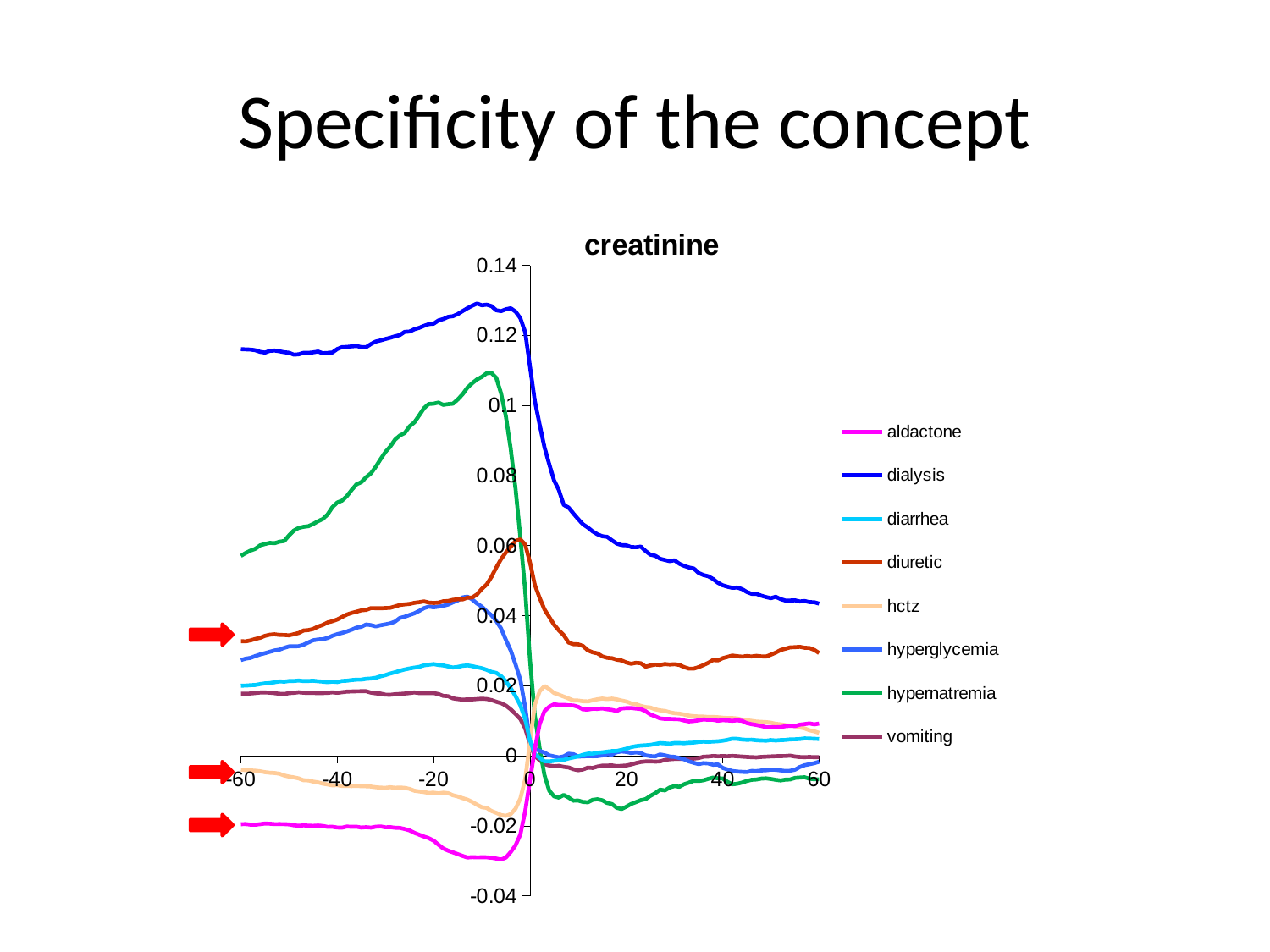
What is the title of the chart? creatinine Is the value of the diuretic line at x = 60 greater or less than 0.02? greater At x = -60, which is larger: the dialysis value or the hypernatremia value? dialysis Which series reaches the lowest value on the creatinine chart? aldactone Does the dialysis line rise or fall between x = 0 and x = 60? fall Is the value of the hypernatremia line at x = -60 greater or less than 0.04? greater How many series does the legend of the creatinine chart list? 8 Does the hypernatremia line rise or fall between x = -60 and x = -10? rise Which series has the highest values on the creatinine chart? dialysis Is the value of the dialysis line at x = -60 greater or less than 0.1? greater What kind of chart is shown on the slide? line chart